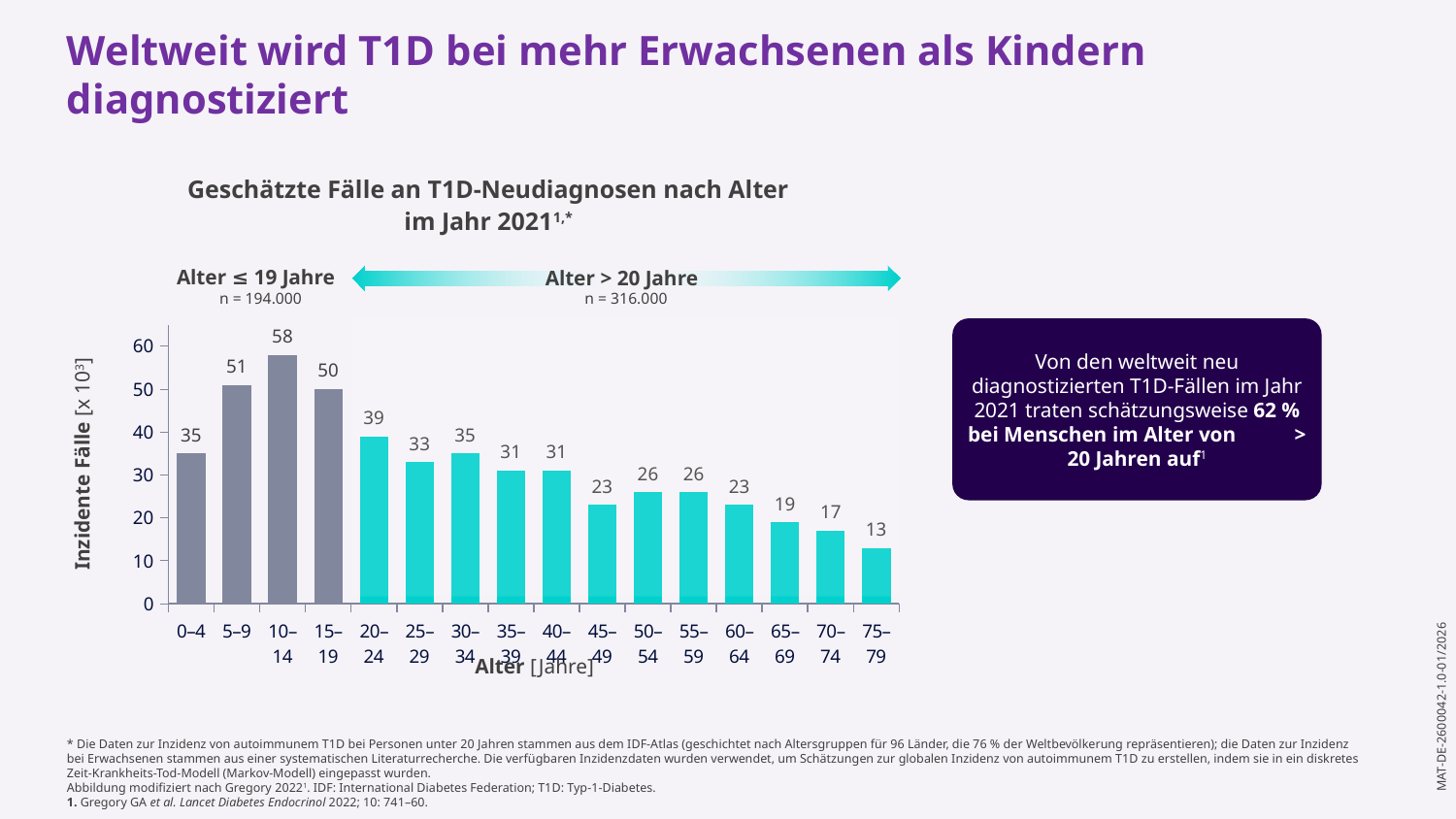
Which is larger, the value for 5–9 or the value for 20–24? 5–9 How many age groups are shown on the x axis? 16 What is the n value given for the group 'Alter > 20 Jahre'? n = 316.000 What is the value for the 20–24 age group? 39 Which age group has the highest value? 10–14 Do the values rise or fall from the 20–24 age group to the 75–79 age group? fall What is the value for the 10–14 age group? 58 What is the difference between the values for the 10–14 and 15–19 age groups? 8 What kind of chart is shown on the slide? bar chart Which age group has the lowest value? 75–79 Is the value for the 45–49 age group greater or less than 30? less What is the value for the 75–79 age group? 13